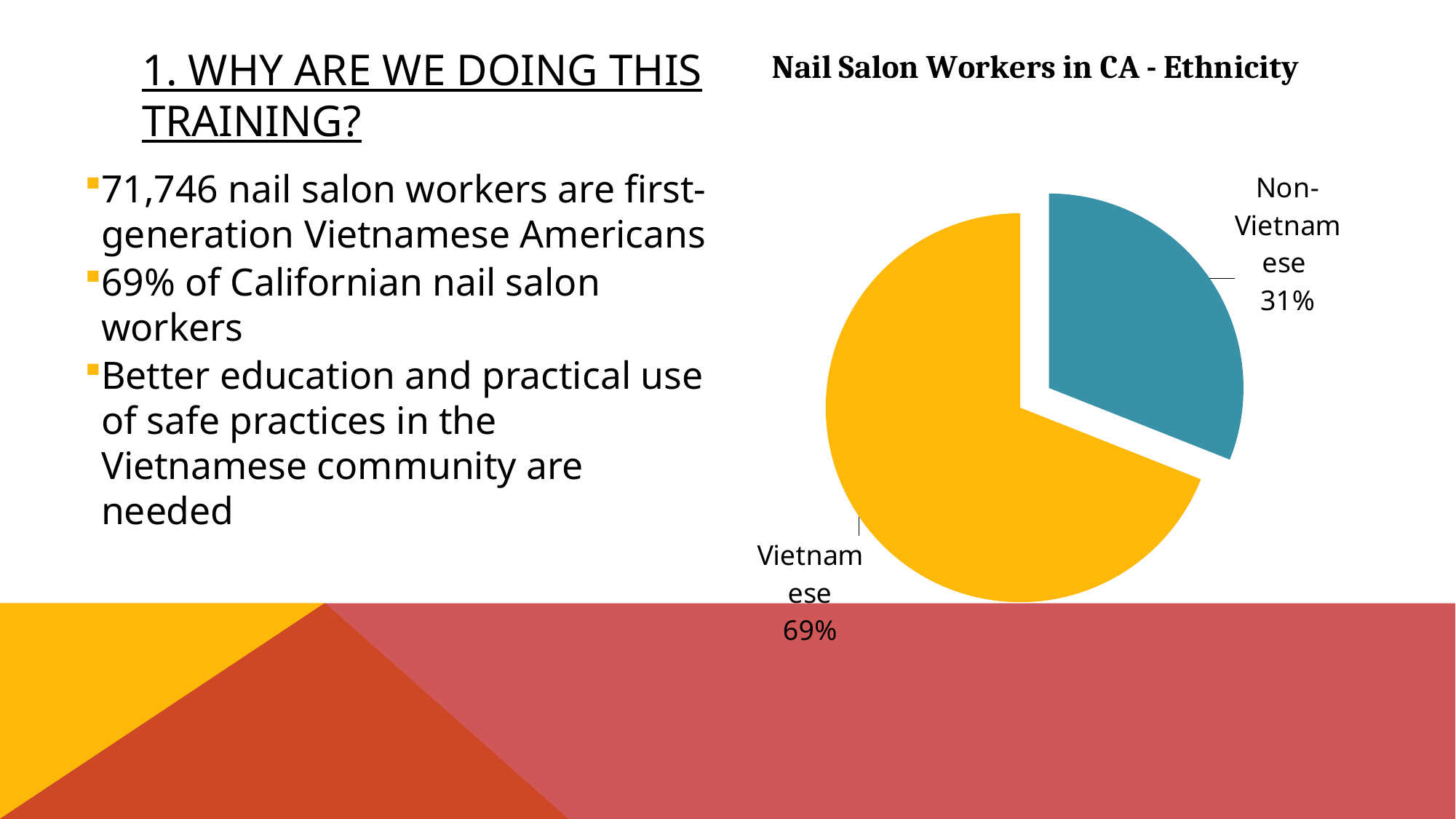
What percentage of the pie is the Vietnamese slice? 69% Which slice of the pie is the largest? Vietnamese What is the difference in percentage points between the Vietnamese and Non-Vietnamese slices? 38 What is the title of the chart? Nail Salon Workers in CA - Ethnicity What type of chart is shown on the slide? Pie chart What colour is the Vietnamese slice of the pie? Yellow How many slices does the pie chart have? 2 What percentage of the pie is the Non-Vietnamese slice? 31% Which is larger, the Vietnamese slice or the Non-Vietnamese slice? Vietnamese Which slice of the pie is the smallest? Non-Vietnamese What is the share of the pie taken by the Non-Vietnamese slice? 31%